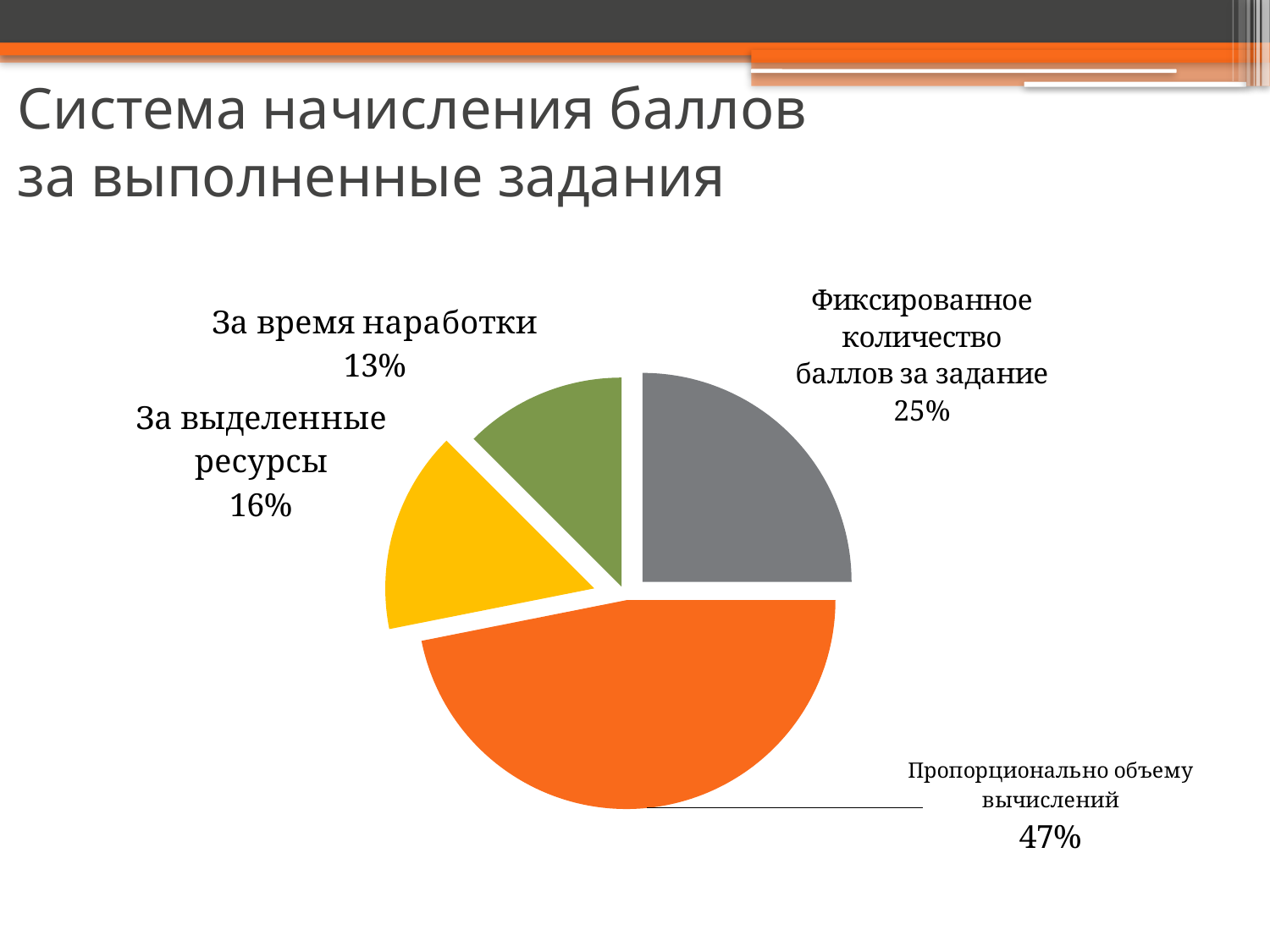
What is the difference between the shares of "Пропорционально объему вычислений" and "Фиксированное количество баллов за задание"? 22% What is the difference between "За выделенные ресурсы" and "За время наработки"? 3% What is the value for "Фиксированное количество баллов за задание"? 25% What kind of chart is shown on the slide? pie chart What is the value for "За время наработки"? 13% What share of the pie does "Пропорционально объему вычислений" have? 47% Which slice of the pie is the smallest? За время наработки Which slice of the pie is the largest? Пропорционально объему вычислений What colour is the slice for "Пропорционально объему вычислений"? orange What is the value for "За выделенные ресурсы"? 16% Which is larger: "За выделенные ресурсы" or "За время наработки"? За выделенные ресурсы How many slices does the pie chart have? 4